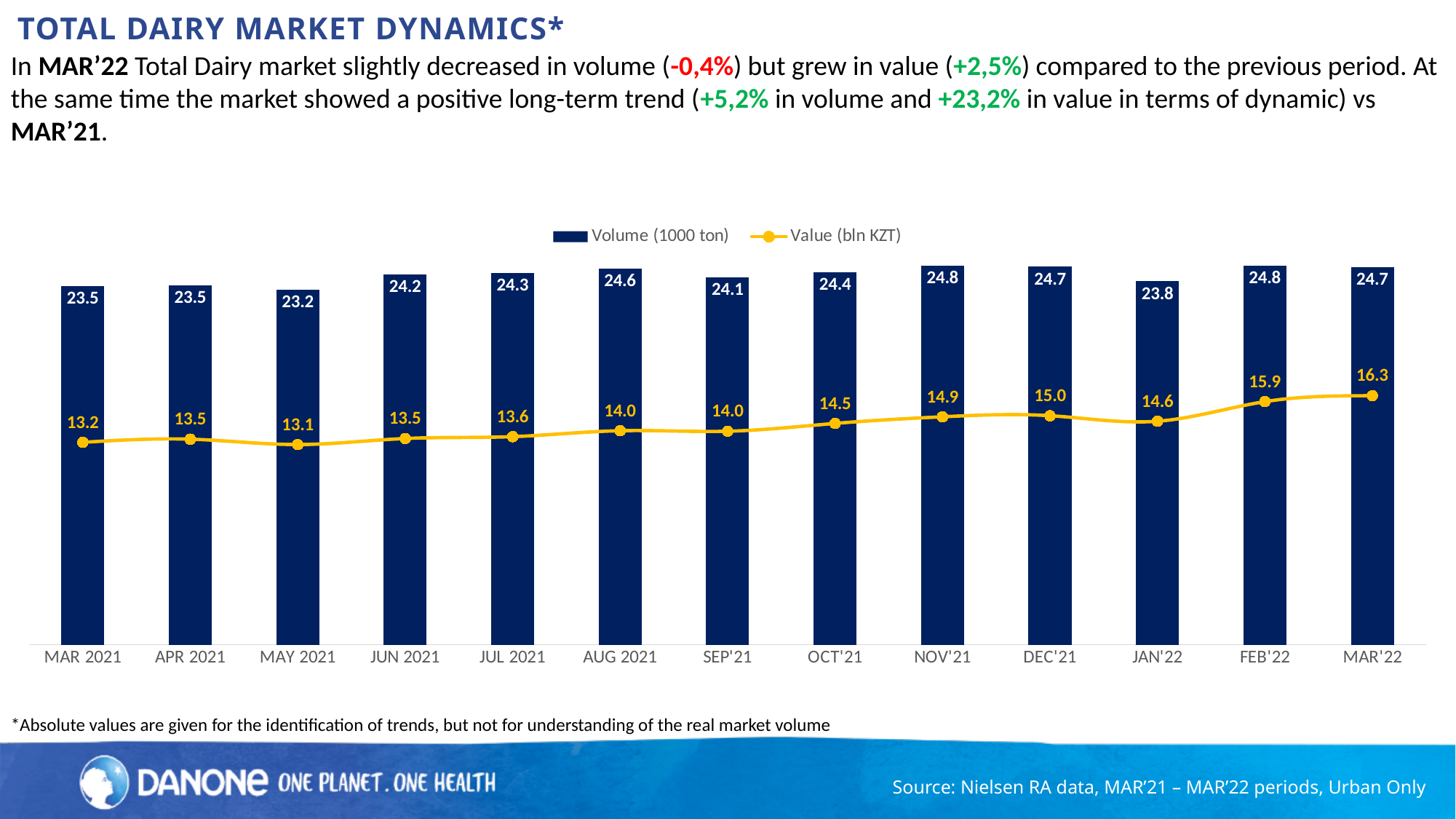
Which month has the highest Value (bln KZT)? MAR'22 Does the Value (bln KZT) line generally rise or fall from MAR 2021 to MAR'22? rise Which month has the lowest Value (bln KZT)? MAY 2021 How many series does the legend list? 2 Which is larger, the Volume (1000 ton) for AUG 2021 or for SEP'21? AUG 2021 How many months are shown on the x axis? 13 What is the Volume (1000 ton) for JUN 2021? 24.2 What is the Value (bln KZT) for JAN'22? 14.6 What is the difference in Value (bln KZT) between MAR'22 and MAR 2021? 3.1 Which month has the lowest Volume (1000 ton)? MAY 2021 What is the Volume (1000 ton) for MAR'22? 24.7 What is the difference in Volume (1000 ton) between NOV'21 and JAN'22? 1.0